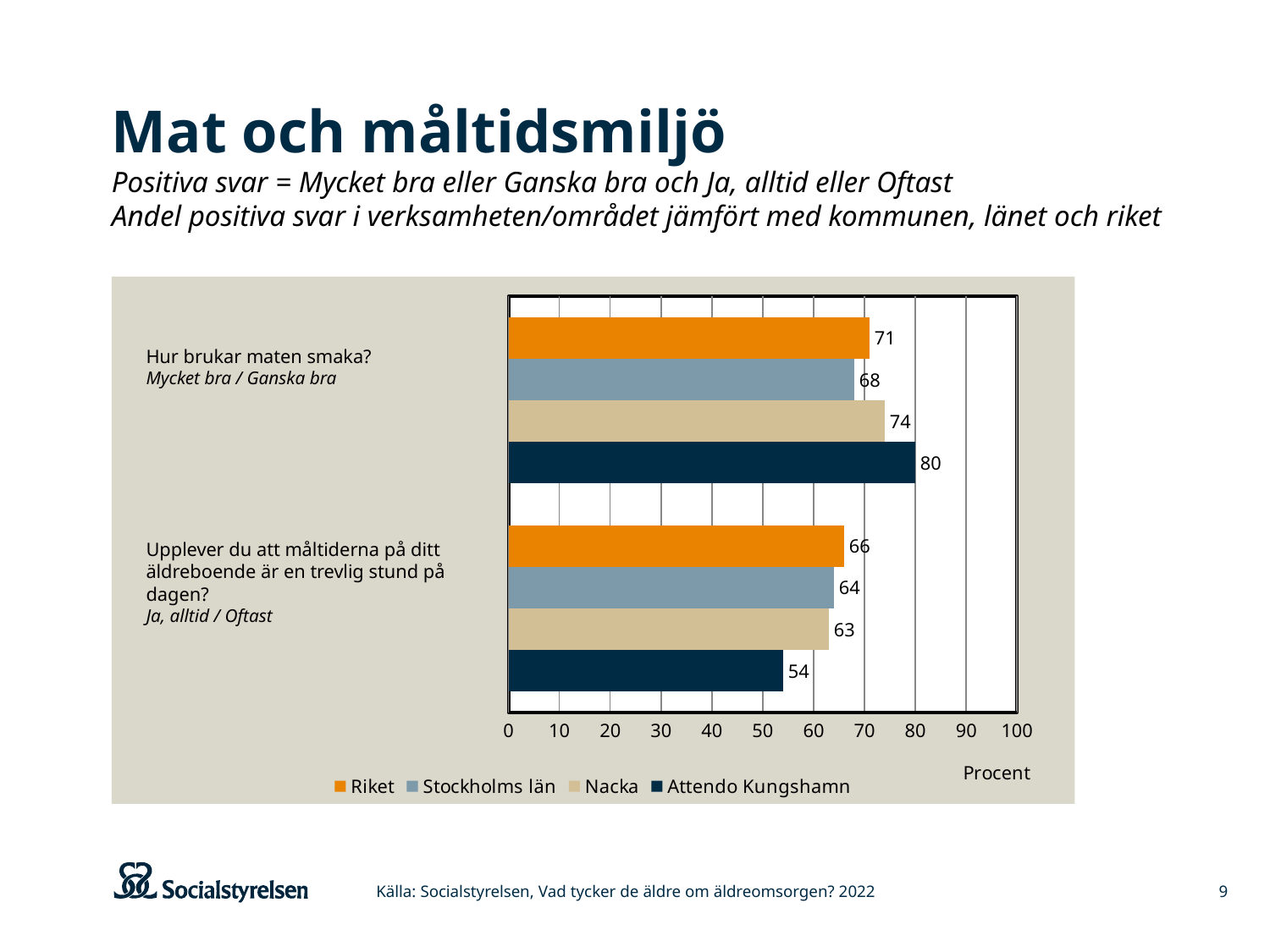
What is the value for Stockholms län on the question "Upplever du att måltiderna på ditt äldreboende är en trevlig stund på dagen?"? 64 How many series does the legend list? 4 What is the value for Attendo Kungshamn on the question "Hur brukar maten smaka?"? 80 What kind of chart is shown on the slide? Bar chart What is the difference between the Attendo Kungshamn value and the Riket value for "Hur brukar maten smaka?"? 9 Is the value for Attendo Kungshamn on "Upplever du att måltiderna på ditt äldreboende är en trevlig stund på dagen?" greater or less than 60? less What unit label is shown on the x axis of the chart? Procent Which series has the highest value for "Hur brukar maten smaka?"? Attendo Kungshamn Which series has the lowest value for "Upplever du att måltiderna på ditt äldreboende är en trevlig stund på dagen?"? Attendo Kungshamn Which is larger for "Upplever du att måltiderna på ditt äldreboende är en trevlig stund på dagen?": Riket or Attendo Kungshamn? Riket What is the value for Riket on the question "Upplever du att måltiderna på ditt äldreboende är en trevlig stund på dagen?"? 66 What is the value for Nacka on the question "Hur brukar maten smaka?"? 74